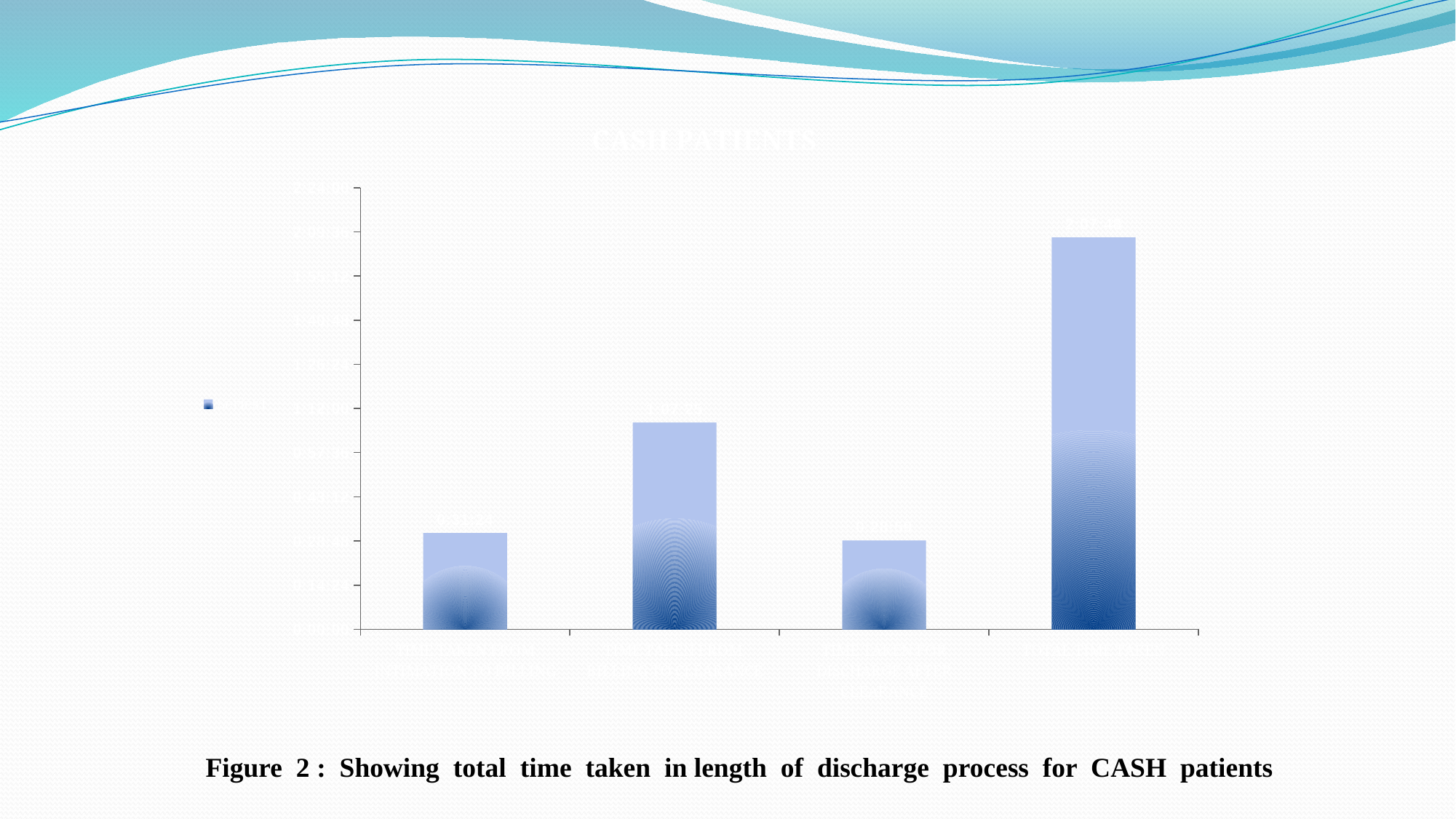
What kind of chart is shown on the slide? bar chart Do the bar heights rise steadily from left to right across the chart? no How many series does the legend list? 1 What colour are the bars in the chart? blue Which is taller, the first bar or the second bar from the left? the second bar Which is taller, the second bar or the fourth bar from the left? the fourth bar How many bars are plotted in the chart? 4 Which is taller, the first bar or the third bar from the left? the first bar What is the figure caption below the chart? Figure 2: Showing total time taken in length of discharge process for CASH patients Which bar is the shortest in the chart, counting from the left? the third bar Which bar is the tallest in the chart, counting from the left? the fourth (rightmost) bar